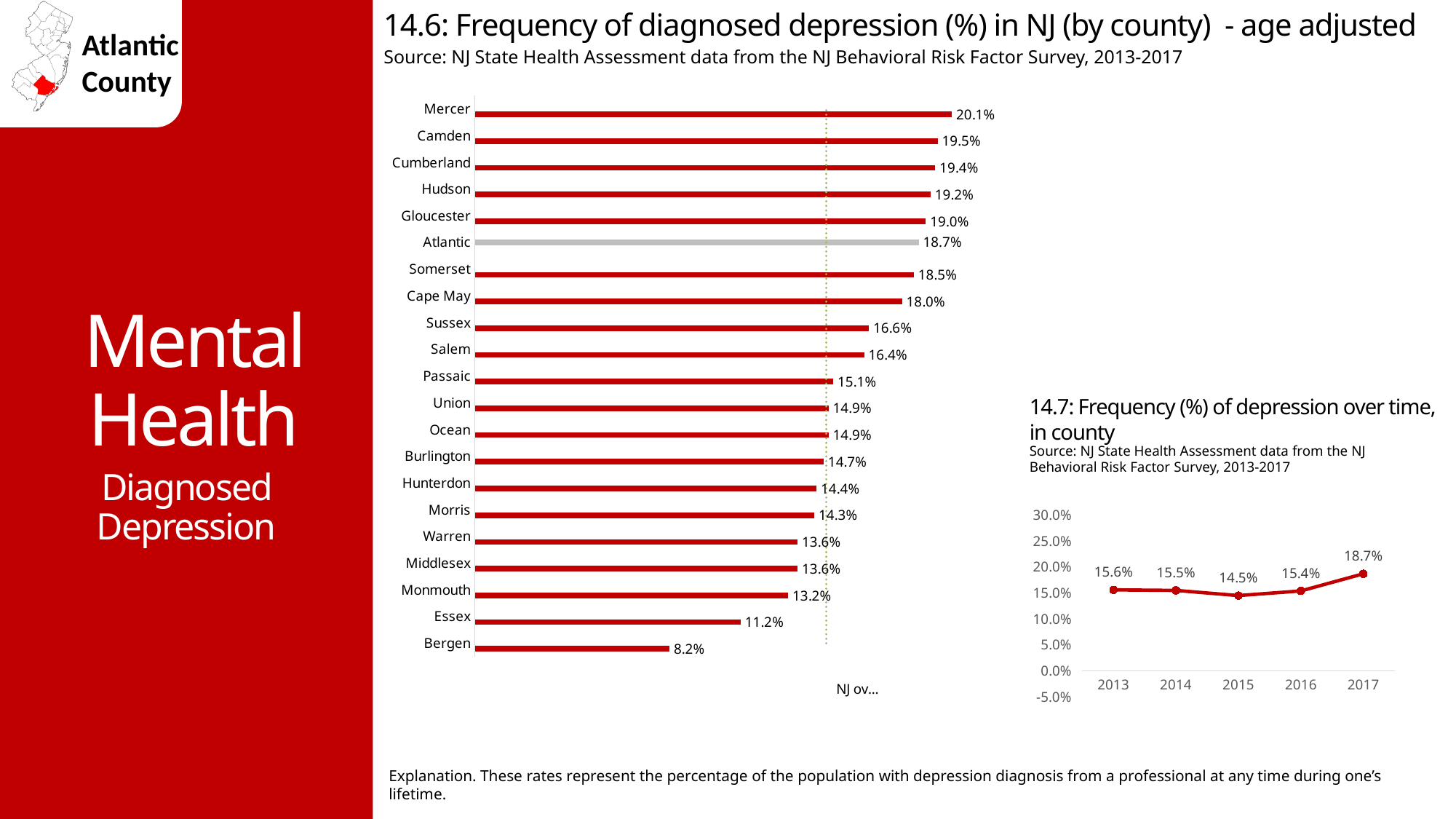
What kind of chart is chart 14.6 (Frequency of diagnosed depression by county)? Bar chart In chart 14.6 (Frequency of diagnosed depression by county), what is the difference between Mercer and Bergen? 11.9% In chart 14.6 (Frequency of diagnosed depression by county), what is the value for Cape May? 18.0% In chart 14.7 (Frequency of depression over time, in county), which year has the highest value? 2017 In chart 14.6 (Frequency of diagnosed depression by county), what is the value for Atlantic? 18.7% In chart 14.6 (Frequency of diagnosed depression by county), which county has the lowest value? Bergen In chart 14.6 (Frequency of diagnosed depression by county), which county has the highest value? Mercer In chart 14.6 (Frequency of diagnosed depression by county), how many counties are shown? 21 In chart 14.7 (Frequency of depression over time, in county), what is the value for 2015? 14.5% In chart 14.7 (Frequency of depression over time, in county), how many years are plotted? 5 In chart 14.6 (Frequency of diagnosed depression by county), which is larger, Camden or Gloucester? Camden In chart 14.7 (Frequency of depression over time, in county), what is the difference between 2017 and 2016? 3.3%